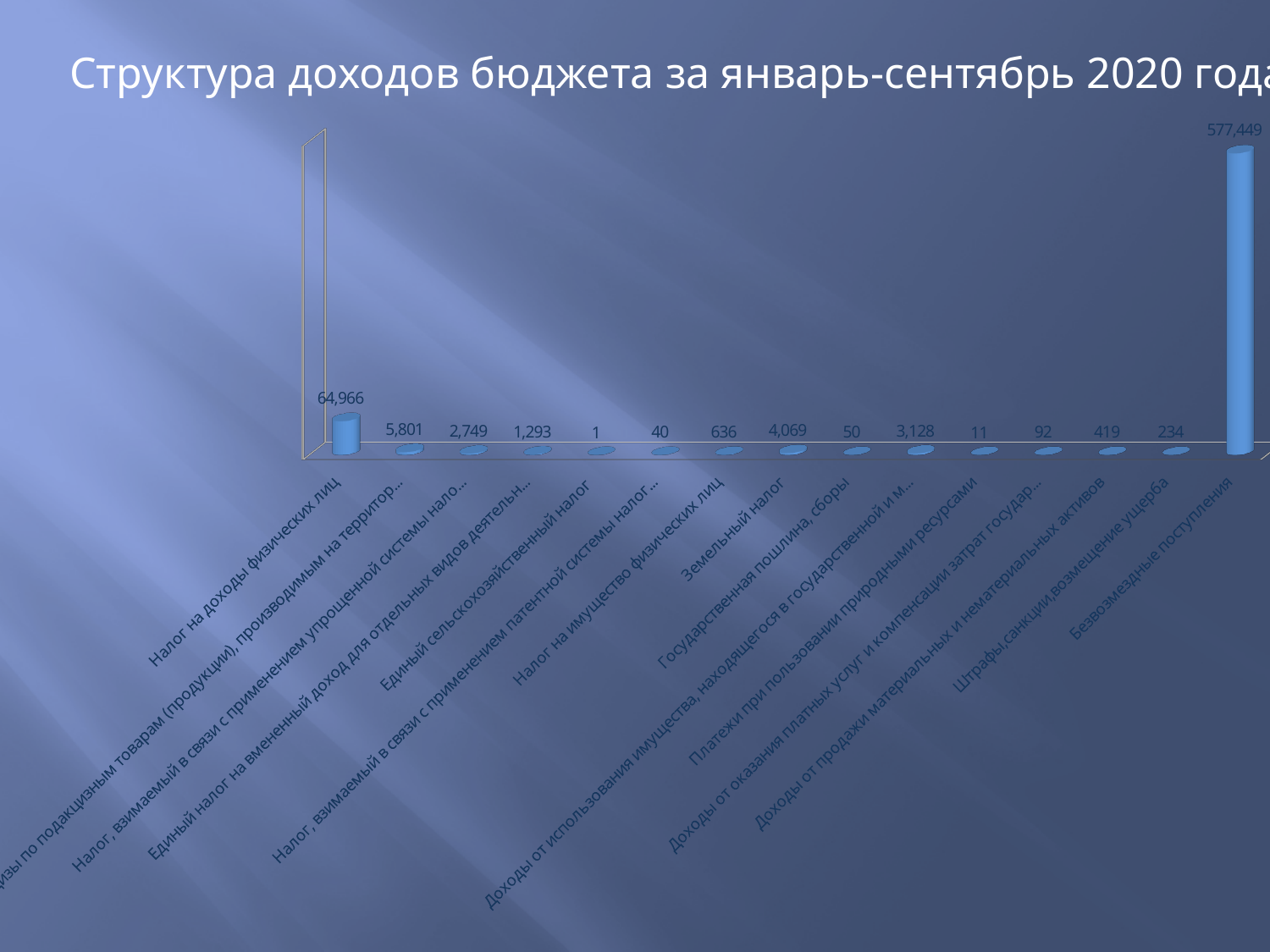
Which category has the highest value? Безвозмездные поступления What is the value for Налог на доходы физических лиц? 64,966 What is the value for Земельный налог? 4,069 Which category has the lowest value? Единый сельскохозяйственный налог What is the value for Платежи при пользовании природными ресурсами? 11 Which is larger: the value for Земельный налог or the value for Налог на имущество физических лиц? Земельный налог What is the title of the chart? Структура доходов бюджета за январь-сентябрь 2020 года How many categories are plotted on the chart? 15 What is the value for Безвозмездные поступления? 577,449 What is the difference between the values for Безвозмездные поступления and Налог на доходы физических лиц? 512,483 What is the value for Единый сельскохозяйственный налог? 1 What kind of chart is shown on the slide? Bar chart